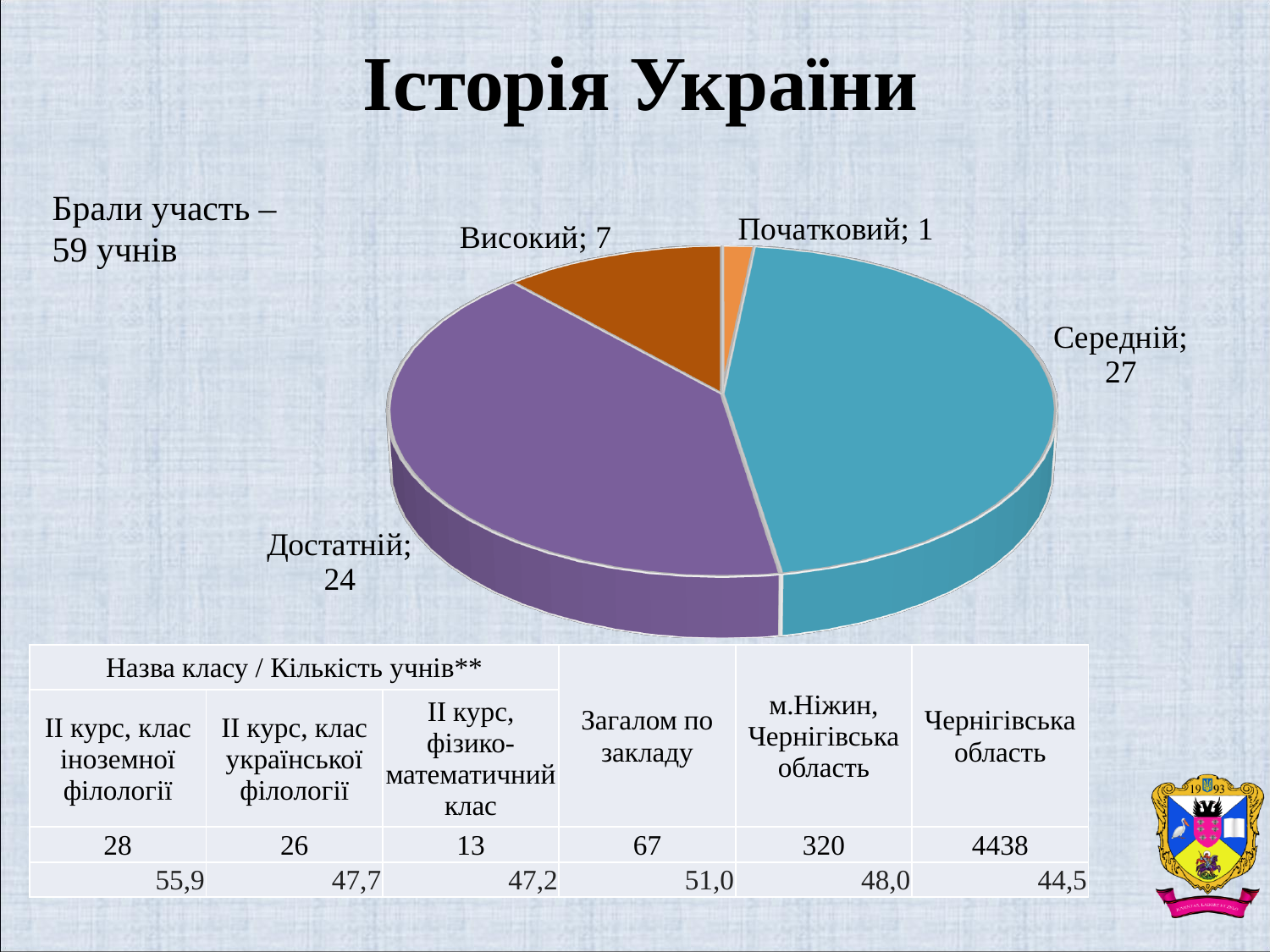
Which category has the largest slice in the pie chart? Середній What is the value for the Початковий slice of the pie chart? 1 Which category has the smallest slice in the pie chart? Початковий Which is larger in the pie chart, Високий or Достатній? Достатній What is the difference between the Високий and Початковий values in the pie chart? 6 How many slices does the pie chart have? 4 What is the title of the slide containing the pie chart? Історія України What is the value for the Високий slice of the pie chart? 7 What is the value for the Достатній slice of the pie chart? 24 What is the difference between the Середній and Достатній values in the pie chart? 3 What kind of chart is shown on the slide? Pie chart What is the value for the Середній slice of the pie chart? 27